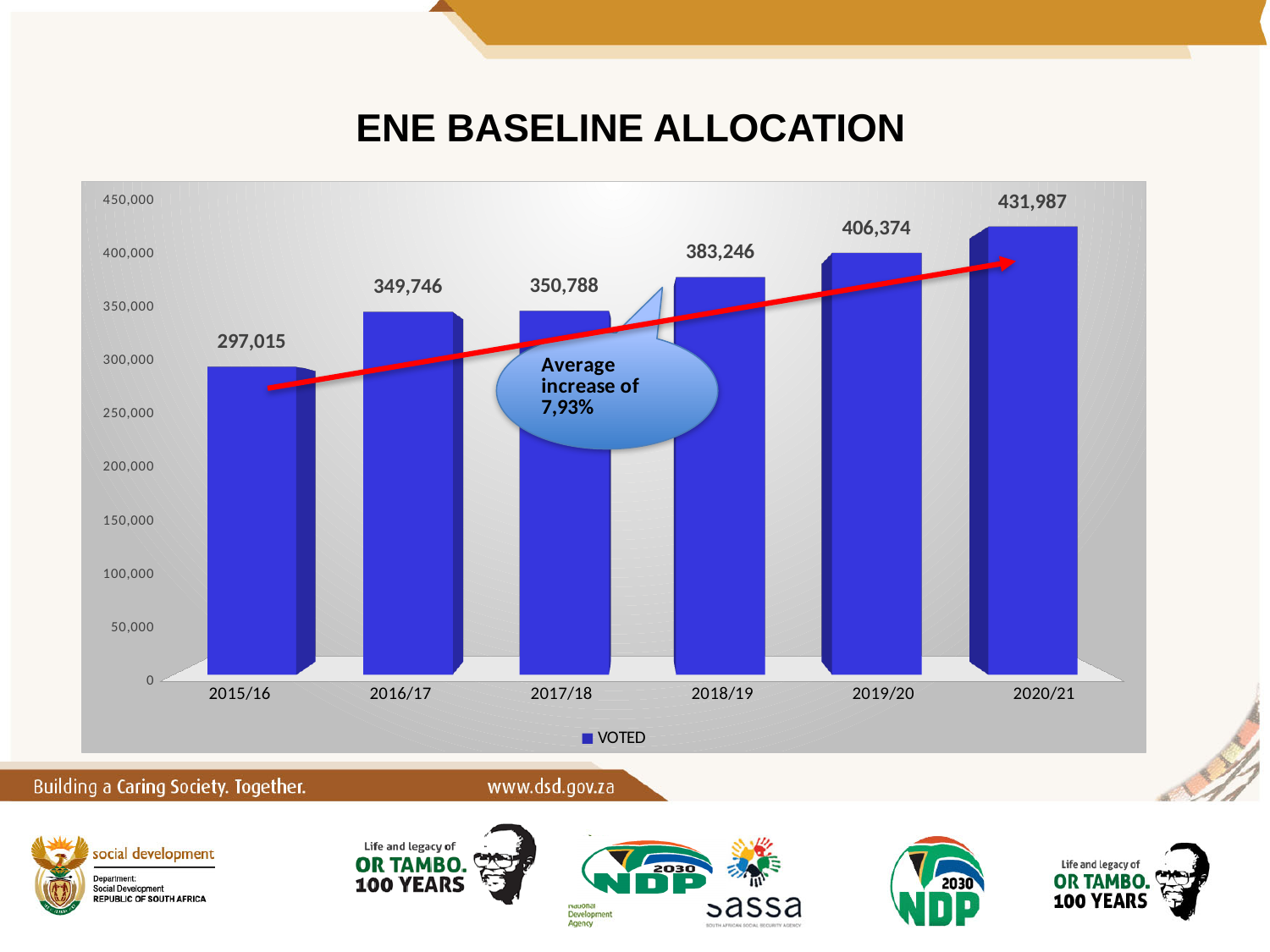
Which is larger, the value for 2018/19 or the value for 2017/18? 2018/19 Do the values rise or fall from 2015/16 to 2020/21? rise Which year has the lowest VOTED allocation? 2015/16 Is the value for 2019/20 greater or less than 400,000? greater What is the VOTED value for 2018/19? 383,246 What is the difference between the 2020/21 and 2019/20 values? 25,613 What kind of chart is shown? bar chart What is the VOTED value for 2020/21? 431,987 How many years are shown on the x axis? 6 Which year has the highest VOTED allocation? 2020/21 What is the VOTED value for 2015/16? 297,015 What is the difference between the 2016/17 and 2015/16 values? 52,731